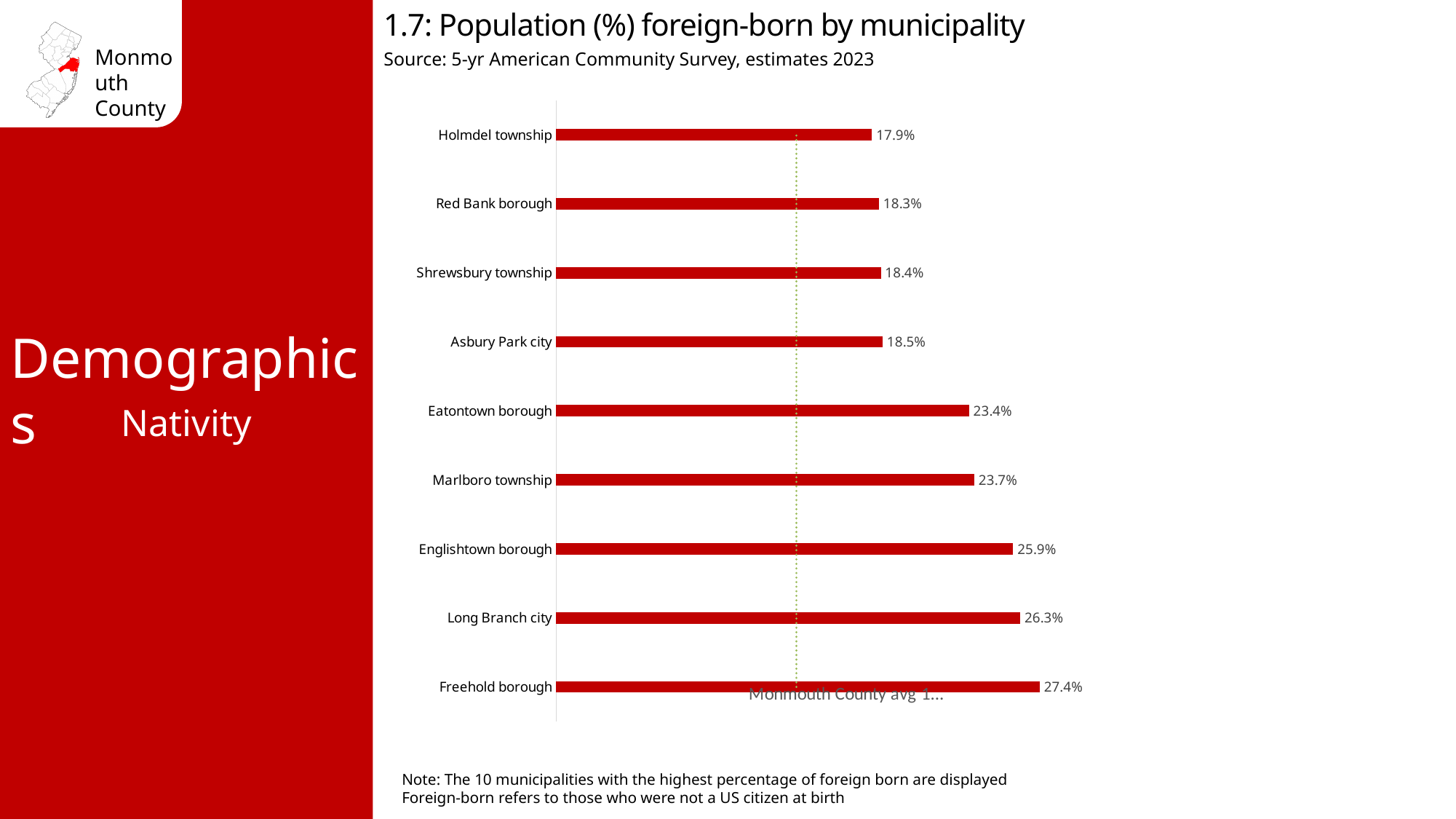
What is the title of the chart? 1.7: Population (%) foreign-born by municipality Which municipality has the highest foreign-born percentage? Freehold borough What is the difference in percentage points between Long Branch city and Englishtown borough? 0.4 Which has a higher foreign-born percentage, Long Branch city or Red Bank borough? Long Branch city What is the foreign-born percentage for Asbury Park city? 18.5% How many municipality bars are shown in the chart? 9 What is the foreign-born percentage for Marlboro township? 23.7% What is the difference in percentage points between Freehold borough and Holmdel township? 9.5 What type of chart is shown on the slide? bar chart Do the bar values increase or decrease going from the top of the chart to the bottom? increase What is the foreign-born percentage for Freehold borough? 27.4% Which municipality has the lowest foreign-born percentage? Holmdel township